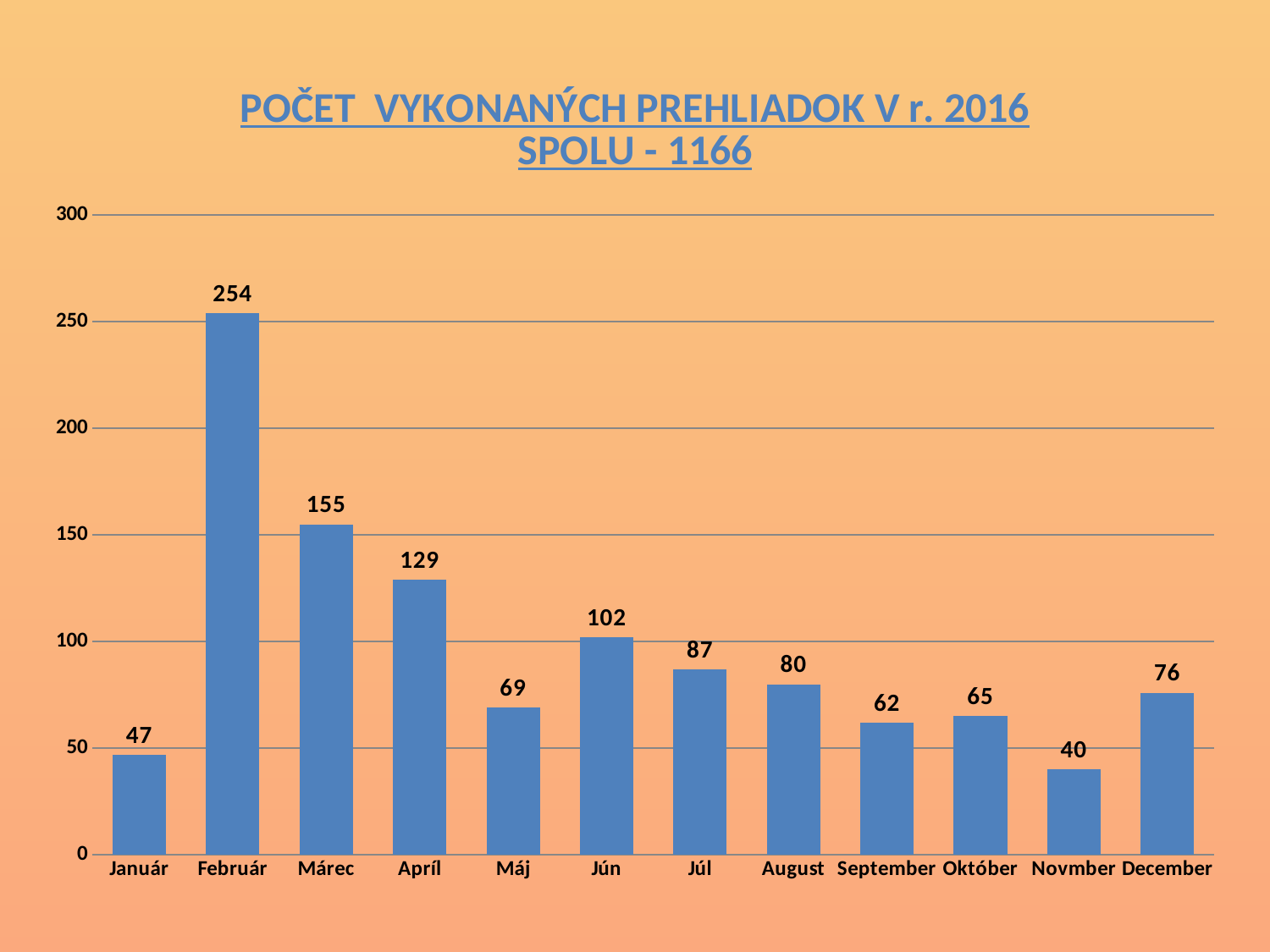
What is the value for December? 76 What is the value for Február? 254 What kind of chart is shown on the slide? bar chart How many months are shown on the x axis? 12 Which month has the lowest value? Novmber What is the value for September? 62 Is the value for Apríl greater or less than 100? greater Which is larger, the value for Júl or the value for August? Júl Which month has the highest value? Február What is the difference between the values for Február and Marec? 99 What is the difference between the values for Jún and Máj? 33 What total is stated in the chart title? 1166